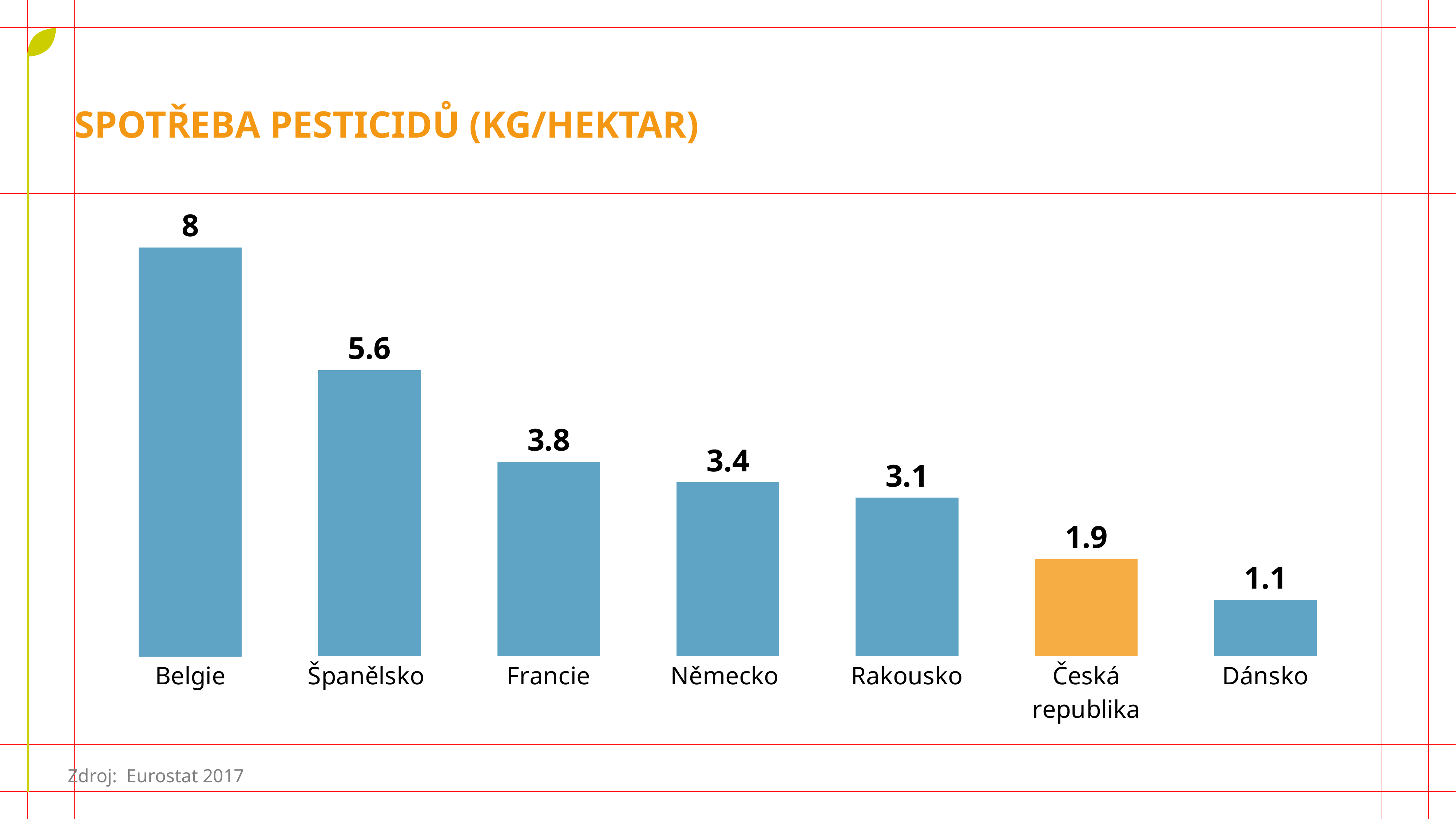
How many countries are shown on the chart? 7 What kind of chart is shown on the slide? Bar chart What is the difference between the values for Belgie and Španělsko? 2.4 Which country's bar is coloured orange instead of blue? Česká republika Which country has the lowest pesticide consumption on the chart? Dánsko What value is shown for Francie? 3.8 Do the values rise or fall from left to right across the chart? Fall What is the pesticide consumption value shown for Belgie? 8 What value is shown for Česká republika? 1.9 What is the difference between the values for Rakousko and Česká republika? 1.2 Which has a larger value, Německo or Rakousko? Německo Which country has the highest pesticide consumption on the chart? Belgie